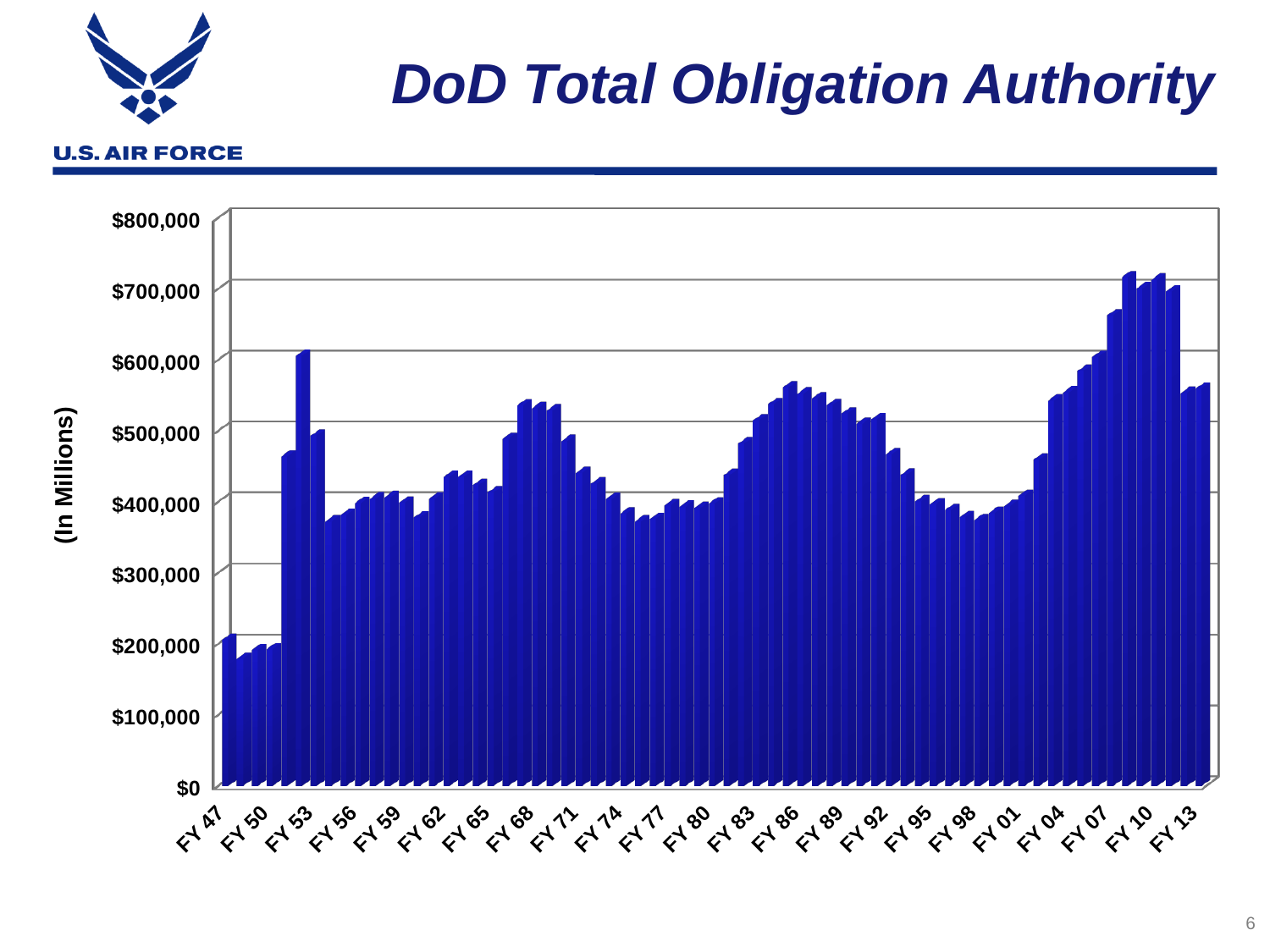
Which is larger, the value for FY 86 or the value for FY 77? FY 86 What is the title of the chart on the slide? DoD Total Obligation Authority Is the value for FY 10 greater or less than $600,000? greater Is the value for FY 68 greater or less than $500,000? greater Is the value for FY 98 greater or less than $400,000? less Do the values generally rise or fall from FY 04 to FY 10? rise What kind of chart is shown on the slide? Bar chart Which is larger, the value for FY 10 or the value for FY 47? FY 10 What unit label is shown on the vertical axis of the chart? (In Millions)